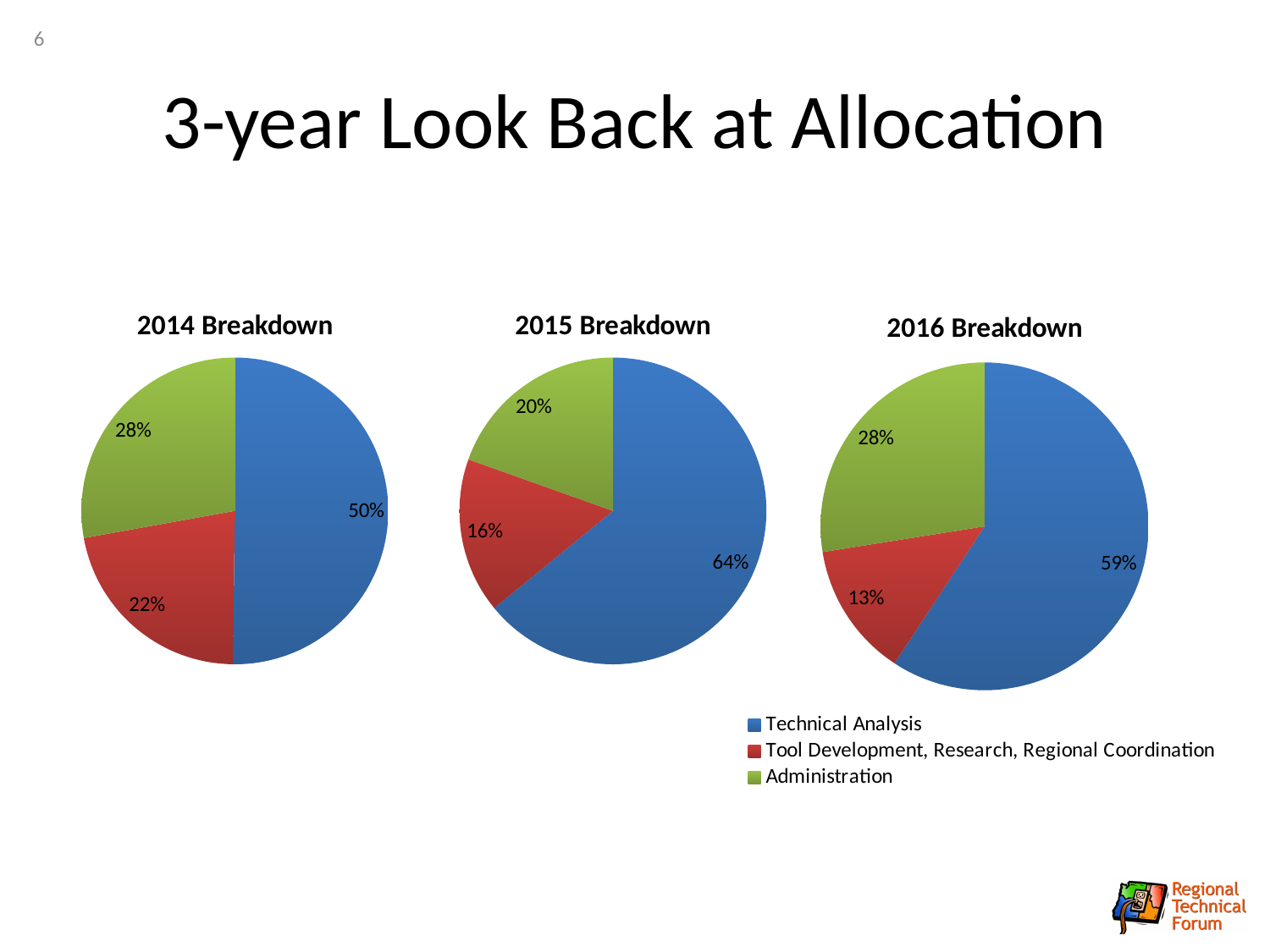
How many slices does the 2014 Breakdown pie chart have? 3 In the 2014 Breakdown chart, what is the difference between the Administration share and the Tool Development, Research, Regional Coordination share? 6% What type of chart is the 2016 Breakdown chart? Pie chart In the 2014 Breakdown chart, what share does Technical Analysis have? 50% In the 2016 Breakdown chart, what share does Tool Development, Research, Regional Coordination have? 13% Which chart shows the highest share for Technical Analysis: 2014, 2015 or 2016 Breakdown? 2015 Breakdown What colour represents Administration in the pie charts? Green In the 2015 Breakdown chart, which category has the largest slice? Technical Analysis In the 2016 Breakdown chart, which category has the smallest slice? Tool Development, Research, Regional Coordination In the 2015 Breakdown chart, what share does Administration have? 20% In the 2015 Breakdown chart, which is larger: Administration or Tool Development, Research, Regional Coordination? Administration How many entries does the legend list? 3